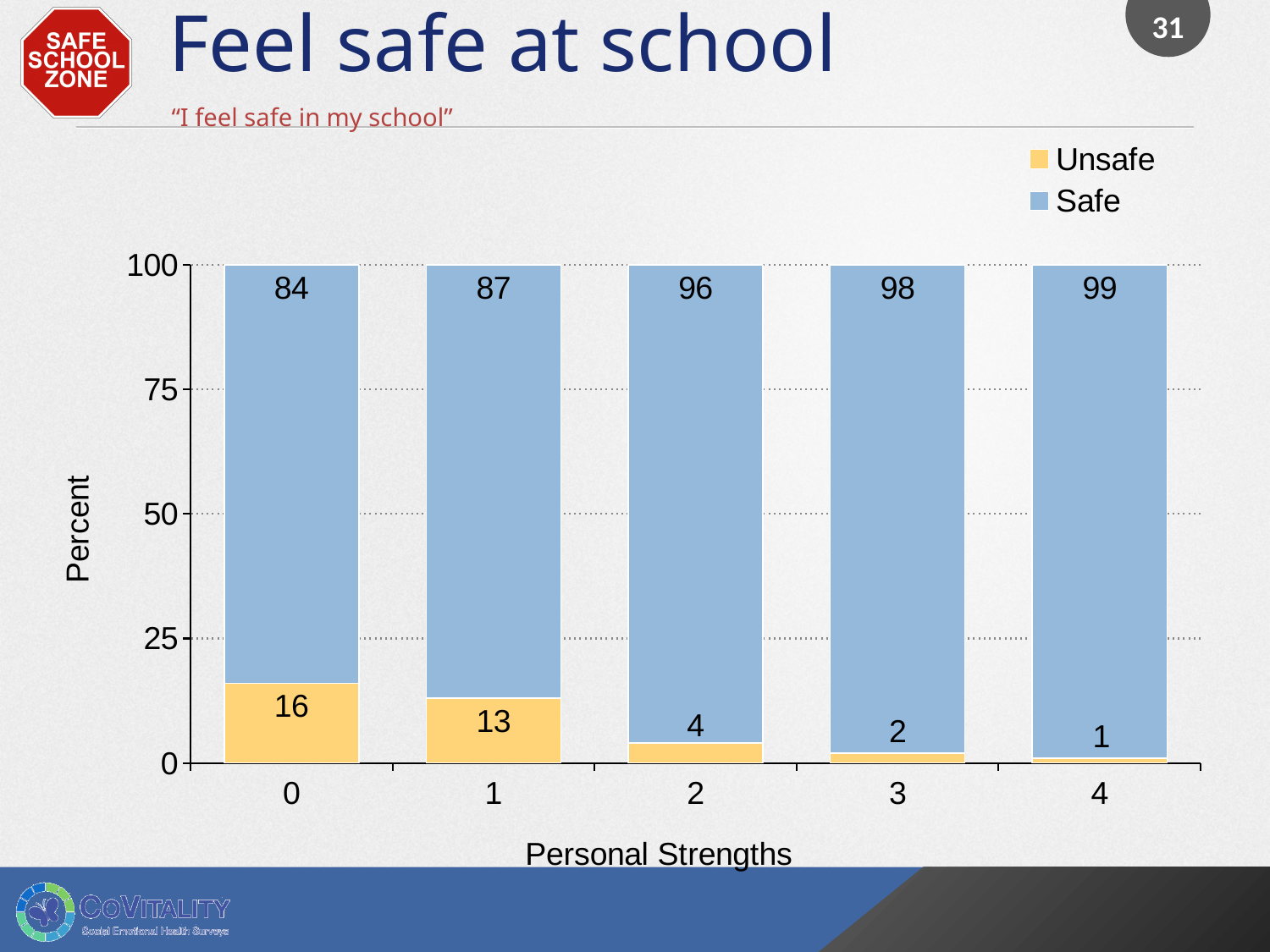
Do the Safe values rise or fall as Personal Strengths increases from 0 to 4? rise Is the Safe value for Personal Strengths category 0 greater or less than 75? greater What is the difference between the Safe values for Personal Strengths categories 4 and 0? 15 How many Personal Strengths categories are shown on the x axis? 5 Which is larger, the Unsafe value for category 1 or the Unsafe value for category 2? category 1 What is the Unsafe value for Personal Strengths category 3? 2 What kind of chart is shown on the slide? stacked bar chart How many series does the legend list? 2 What is the Unsafe value for Personal Strengths category 0? 16 Which Personal Strengths category has the lowest Unsafe value? 4 Which Personal Strengths category has the highest Safe value? 4 What is the Safe value for Personal Strengths category 2? 96